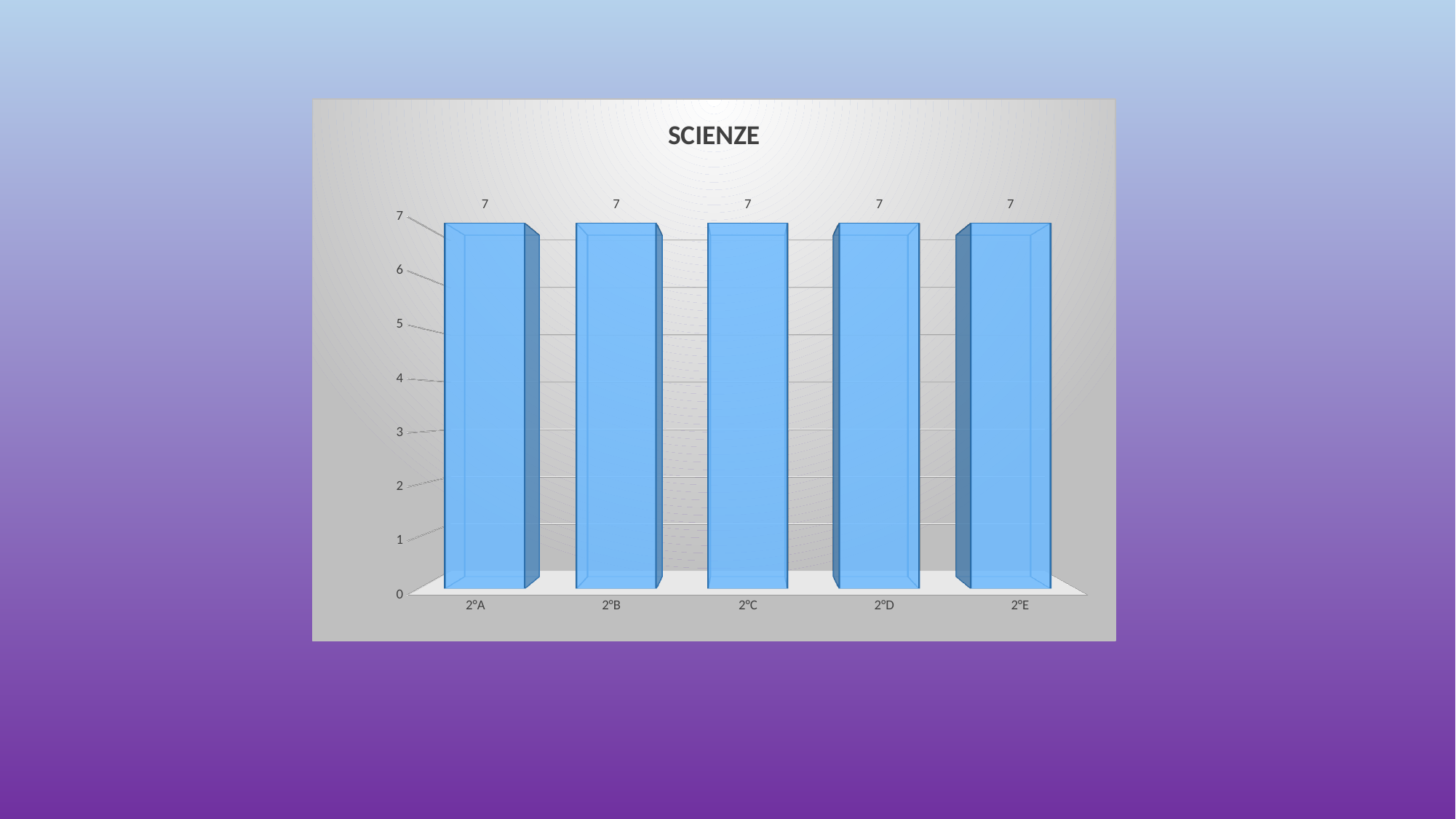
Is the value for 2°B greater or less than 5? greater What is the title of the chart? SCIENZE What is the value for 2°E? 7 What is the highest value shown on the vertical axis? 7 What colour are the bars? blue How many categories are shown on the x axis? 5 Do the values rise, fall, or stay the same from 2°A to 2°E? stay the same What is the difference between the values for 2°B and 2°D? 0 What is the value for 2°A? 7 What is the value for 2°C? 7 What kind of chart is this? bar chart